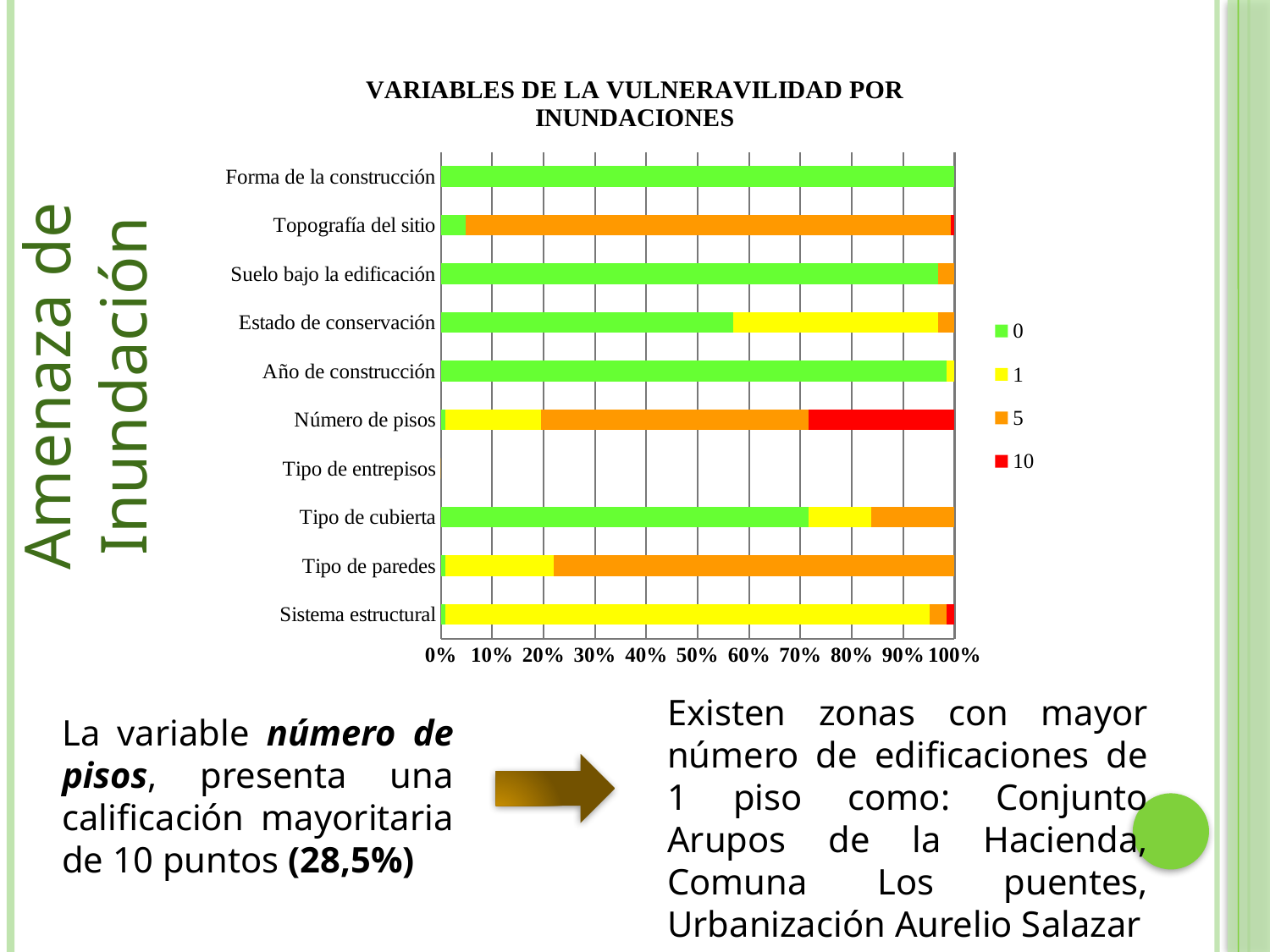
Is the share of the '0' series for Forma de la construcción greater or less than 90%? greater Is the share of the '1' series for Tipo de paredes greater or less than 30%? less Which legend entry is shown in red? 10 Is the share of the '5' series for Topografía del sitio greater or less than 80%? greater How many categories (variables) are listed on the vertical axis of the chart? 10 How many series does the chart legend list? 4 What is the title of the chart? VARIABLES DE LA VULNERAVILIDAD POR INUNDACIONES What kind of chart is shown on the slide? bar chart